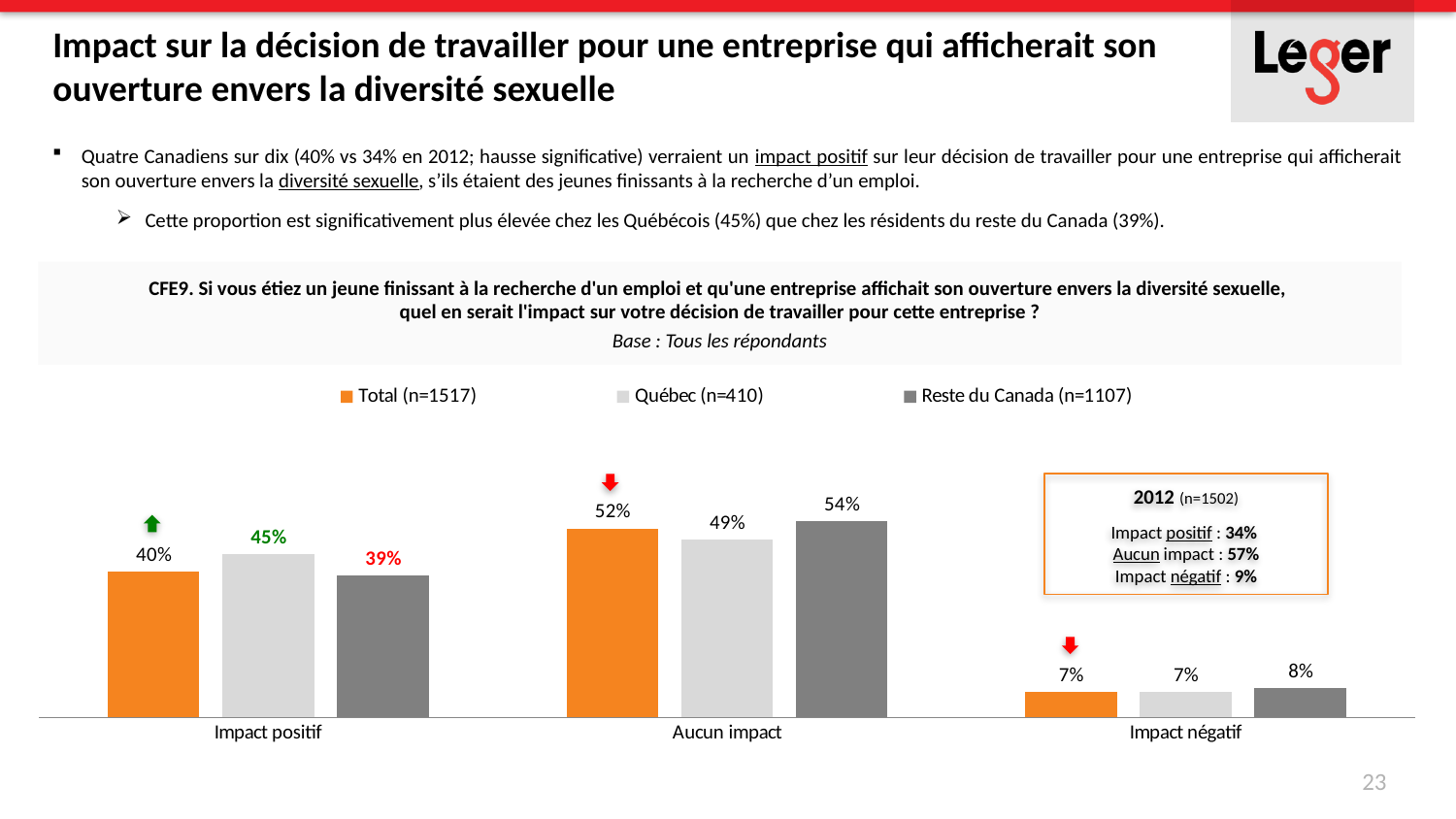
What is the value for Total (n=1517) in the Aucun impact category? 52% Which category has the highest value for the Total (n=1517) series? Aucun impact In the Aucun impact category, which is larger: the Québec (n=410) value or the Reste du Canada (n=1107) value? Reste du Canada (n=1107) Which category has the lowest value for the Québec (n=410) series? Impact négatif What is the value for Québec (n=410) in the Impact positif category? 45% What is the difference between the Québec (n=410) and Reste du Canada (n=1107) values in the Impact positif category? 6 percentage points What kind of chart is shown on the slide? Bar chart How many categories are shown on the x axis of the chart? 3 What is the value for Reste du Canada (n=1107) in the Impact négatif category? 8% What is the difference between the Reste du Canada (n=1107) and Total (n=1517) values in the Aucun impact category? 2 percentage points Which series is shown in orange in the chart? Total (n=1517) How many series does the legend list? 3